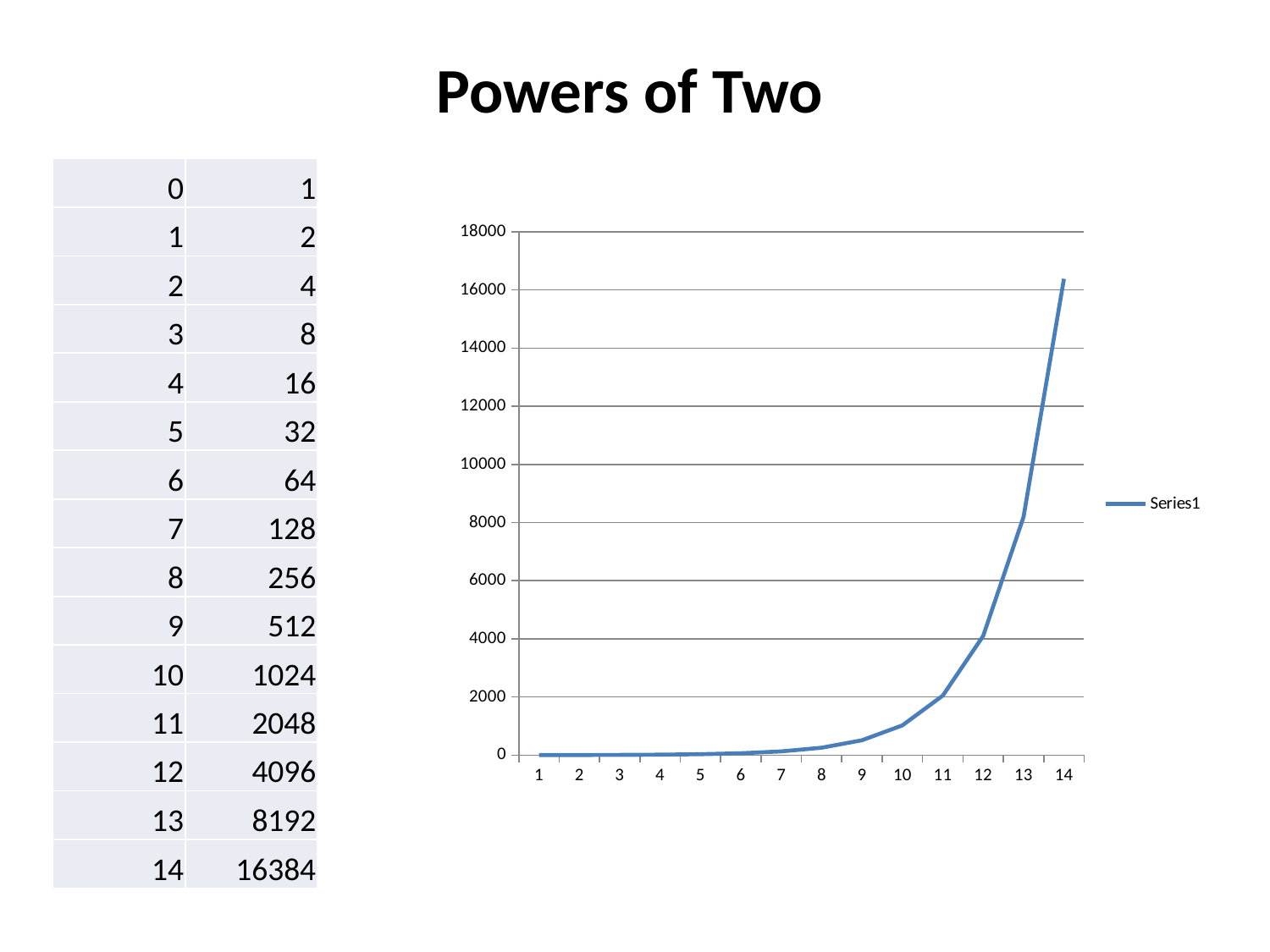
What kind of chart is shown on the slide? line chart What is the title of the slide containing the chart? Powers of Two Which has the larger value in the chart, x = 13 or x = 12? 13 How many series does the chart's legend list? 1 Is the value at x = 12 greater or less than 6000? less Is the value at x = 14 greater or less than 14000? greater Do the values in the chart rise or fall as the x axis goes from 1 to 14? rise Is the value at x = 10 greater or less than 2000? less At which x-axis category does the chart reach its highest value? 14 What is the name of the series shown in the chart's legend? Series1 How many points are plotted along the x axis of the chart? 14